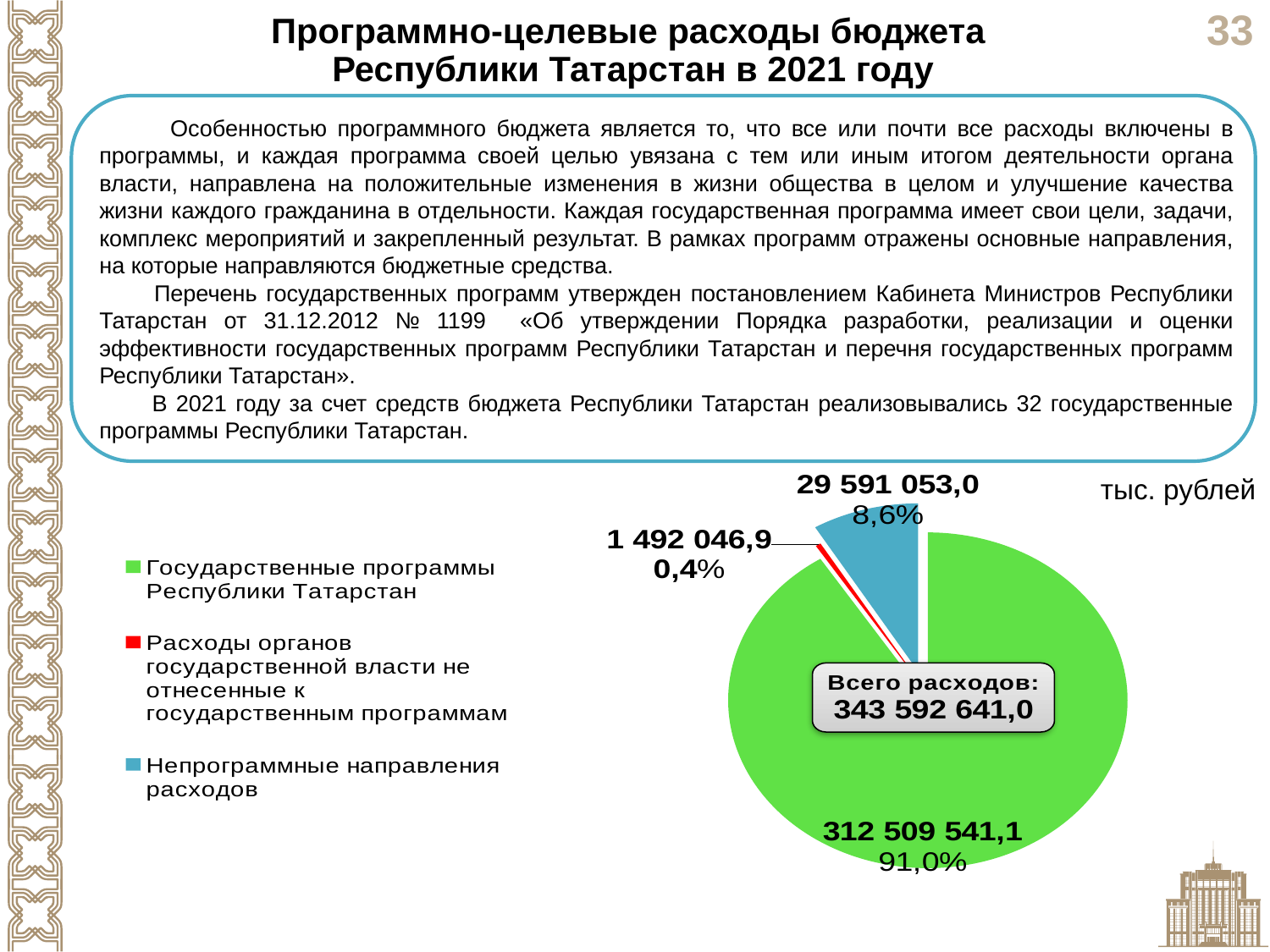
Какая категория имеет наибольшую долю расходов? Государственные программы Республики Татарстан Что больше: непрограммные направления расходов или расходы органов государственной власти, не отнесенные к государственным программам? Непрограммные направления расходов Какова общая сумма расходов, указанная в центре диаграммы? 343 592 641,0 Какова доля расходов органов государственной власти, не отнесенных к государственным программам? 0,4% Какова доля государственных программ Республики Татарстан в общих расходах? 91,0% Какой тип диаграммы показан на слайде? Круговая диаграмма Какое значение приходится на государственные программы Республики Татарстан? 312 509 541,1 Какова доля непрограммных направлений расходов? 8,6% Какое значение приходится на непрограммные направления расходов? 29 591 053,0 Сколько категорий (секторов) показано на круговой диаграмме? 3 Какое значение приходится на расходы органов государственной власти, не отнесенные к государственным программам? 1 492 046,9 Какая категория имеет наименьшую долю расходов? Расходы органов государственной власти не отнесенные к государственным программам